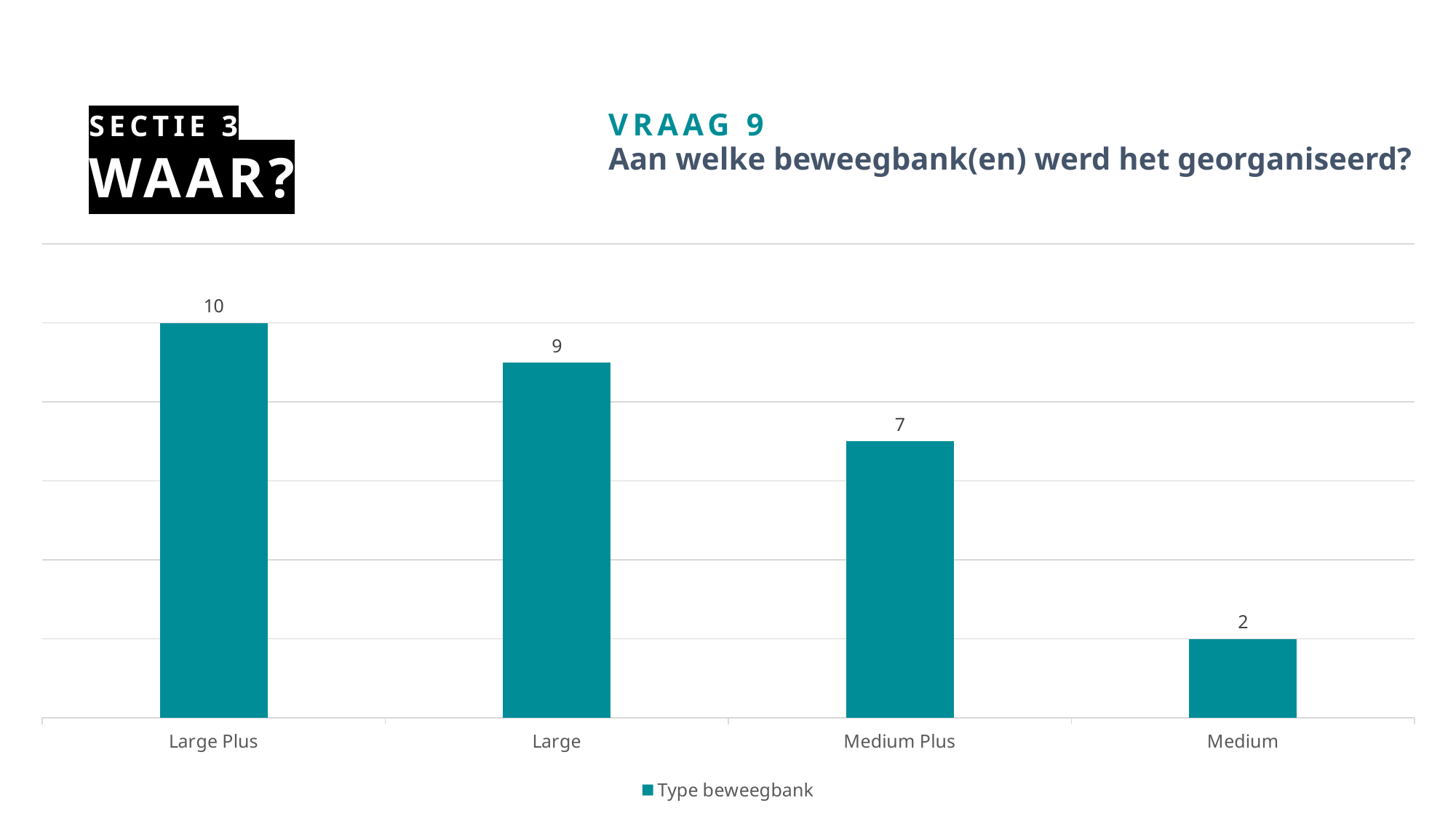
What is the value for Medium Plus? 7 What is the difference between the values for Large and Medium Plus? 2 Which category has the lowest value? Medium What kind of chart is shown on the slide? bar chart What series name does the legend show? Type beweegbank What is the difference between the values for Large Plus and Medium? 8 Which category has the highest value? Large Plus Which is larger, the value for Medium Plus or the value for Medium? Medium Plus What is the value for Large Plus? 10 How many categories are shown on the x axis? 4 What is the value for Medium? 2 What is the value for Large? 9